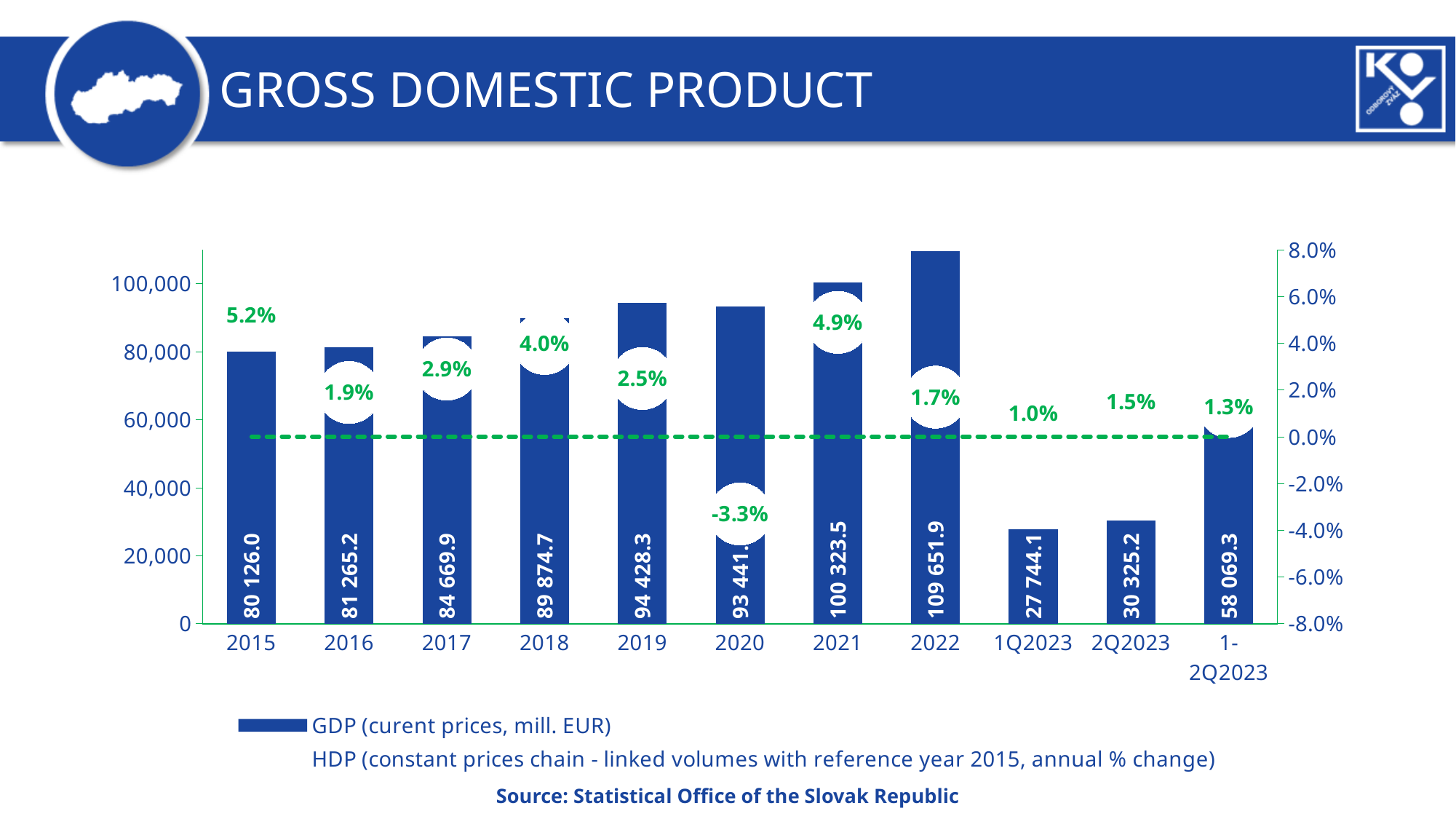
Which has the larger GDP value, 2018 or 2019? 2019 What is the annual % change in HDP shown for 1Q2023? 1.0% What is the difference between the GDP values for 2Q2023 and 1Q2023? 2 581.1 What is the annual % change in HDP shown for 2021? 4.9% How many series does the legend list? 2 What is the GDP (current prices, mill. EUR) value for 2022? 109 651.9 How many categories are shown on the x axis? 11 Which category has the lowest annual % change in HDP? 2020 Which category has the highest GDP (current prices) bar? 2022 Do the GDP bars rise or fall from 2015 to 2019? rise Is the GDP value for 2020 greater or less than 80,000? greater What is the difference between the GDP values for 2022 and 2021? 9 328.4